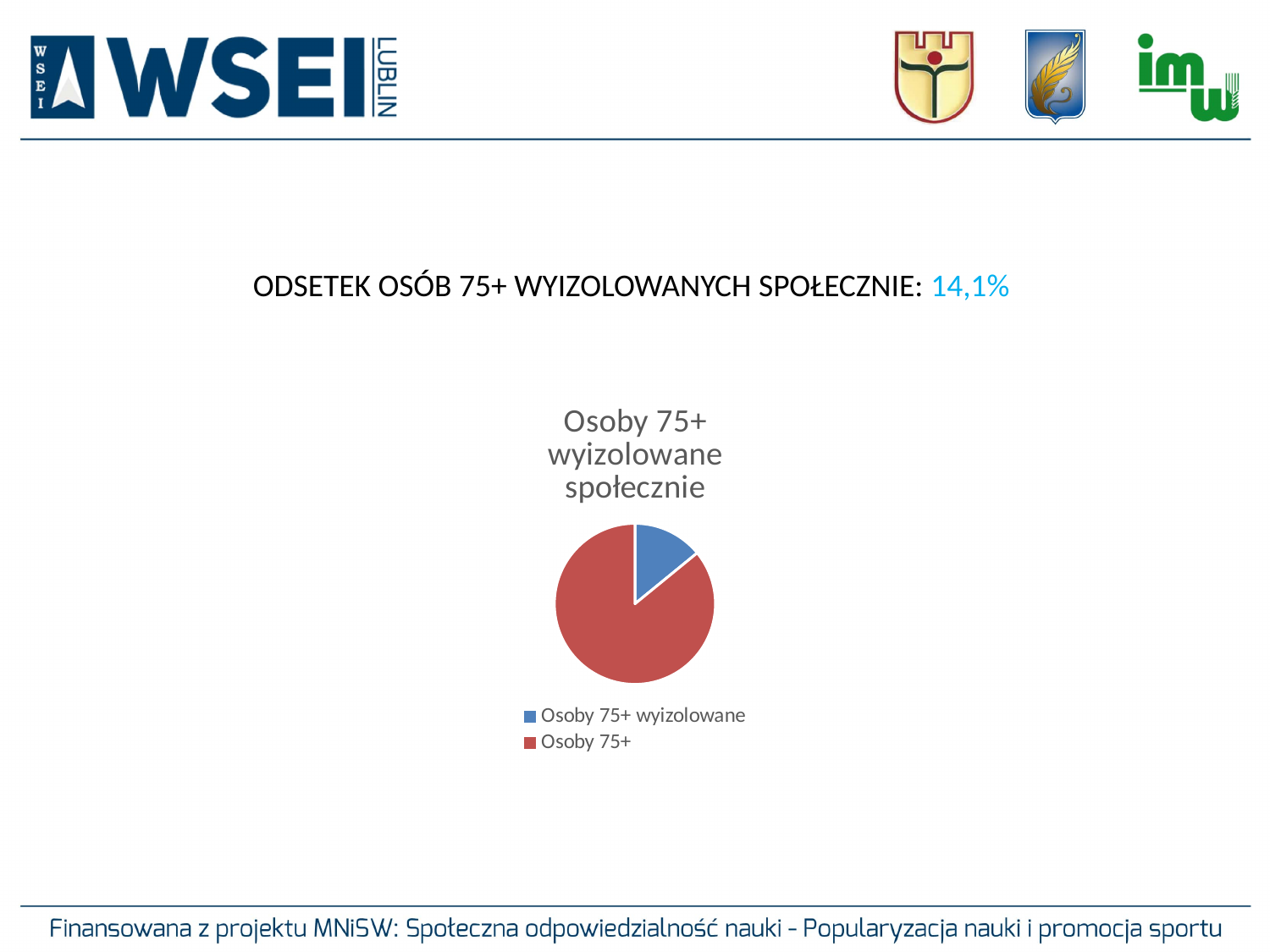
What kind of chart is shown on the slide? pie chart Which slice of the pie chart is the largest? Osoby 75+ How many entries does the legend of the pie chart list? 2 According to the slide, what share of people aged 75+ are socially isolated (Osoby 75+ wyizolowane)? 14,1% Which slice of the pie chart is the smallest? Osoby 75+ wyizolowane What is the title of the pie chart? Osoby 75+ wyizolowane społecznie How many slices does the pie chart have? 2 Which is larger in the pie chart: the slice for Osoby 75+ wyizolowane or the slice for Osoby 75+? Osoby 75+ What colour is the slice for Osoby 75+ wyizolowane in the pie chart? blue